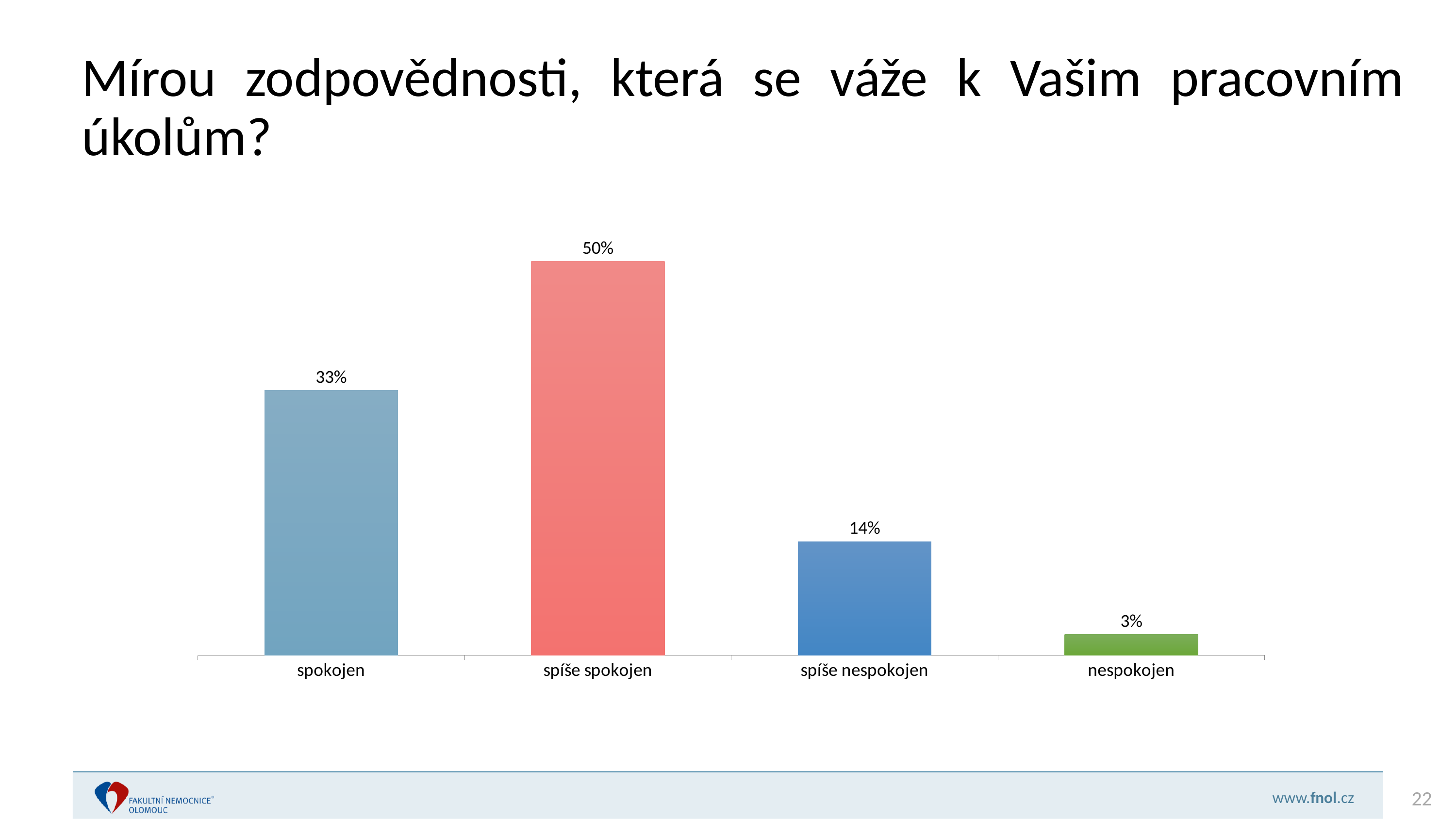
What is the difference between the values for "spíše nespokojen" and "nespokojen"? 11% What is the value for "spokojen"? 33% What is the value for "spíše nespokojen"? 14% Which is larger, the value for "spokojen" or the value for "spíše nespokojen"? spokojen What is the value for "spíše spokojen"? 50% What colour is the bar for "spíše spokojen"? red What kind of chart is shown on the slide? bar chart What is the value for "nespokojen"? 3% What is the difference between the values for "spíše spokojen" and "spokojen"? 17% Which category has the highest value? spíše spokojen Which category has the lowest value? nespokojen How many categories are shown on the x axis? 4